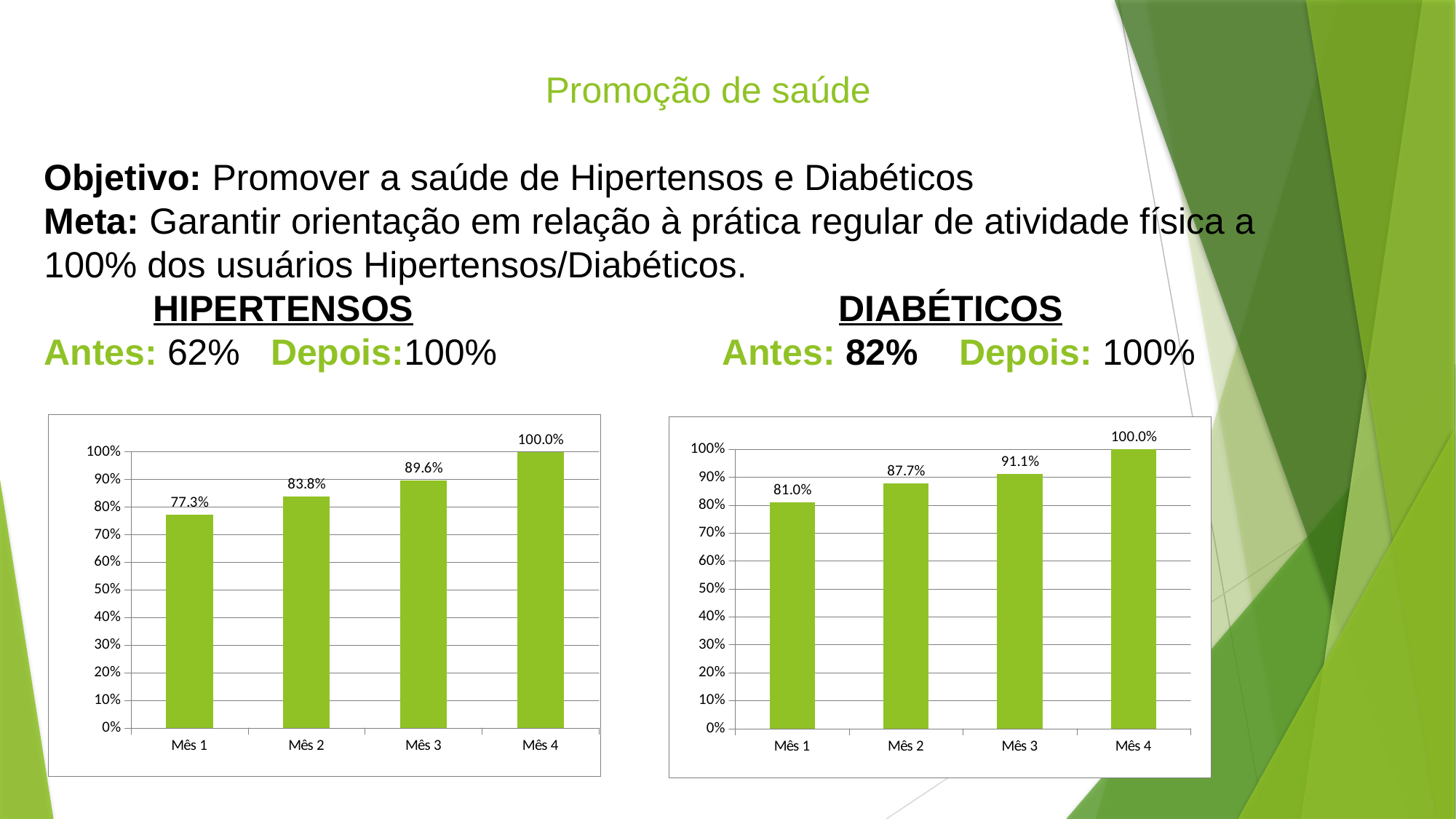
How many months are shown on the x axis of the left chart (HIPERTENSOS)? 4 In the right chart (DIABÉTICOS), what is the difference between the values for Mês 3 and Mês 1? 10.1% Which is larger: the Mês 2 value in the left chart (HIPERTENSOS) or the Mês 2 value in the right chart (DIABÉTICOS)? DIABÉTICOS (87.7%) What kind of chart is the right chart (DIABÉTICOS)? Bar chart In the right chart (DIABÉTICOS), which month has the highest value? Mês 4 In the left chart (HIPERTENSOS), do the values rise or fall from Mês 1 to Mês 4? Rise In the left chart (HIPERTENSOS), what is the value for Mês 3? 89.6% In the left chart (HIPERTENSOS), which month has the lowest value? Mês 1 In the right chart (DIABÉTICOS), what is the value for Mês 4? 100.0% In the left chart (HIPERTENSOS), what is the difference between the values for Mês 4 and Mês 1? 22.7% In the right chart (DIABÉTICOS), what is the value for Mês 2? 87.7% In the left chart (HIPERTENSOS), what is the value for Mês 1? 77.3%